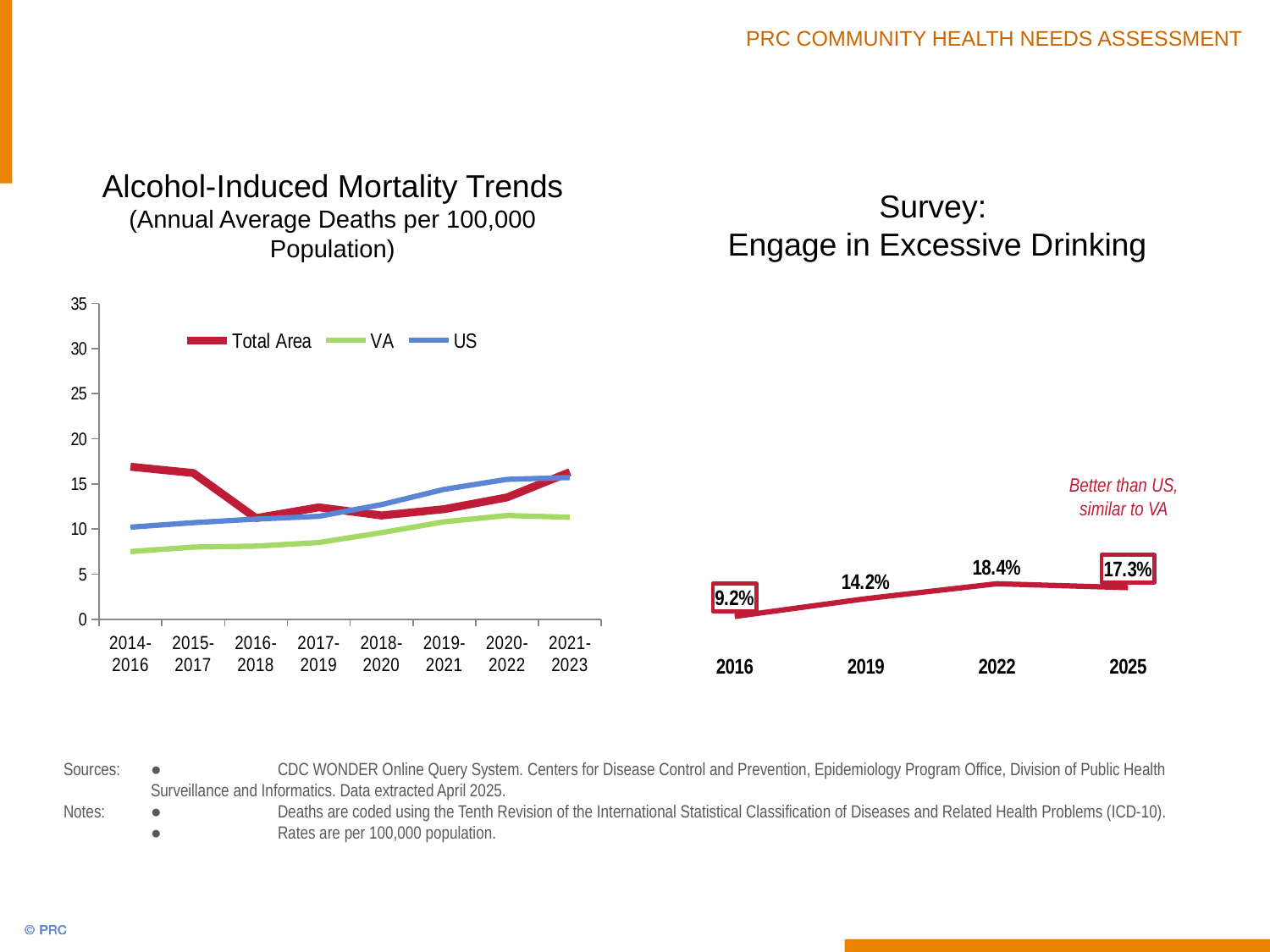
On the Survey: Engage in Excessive Drinking chart, which year has the lowest value? 2016 On the Survey: Engage in Excessive Drinking chart, what is the value for 2025? 17.3% On the Alcohol-Induced Mortality Trends chart, does the VA line generally rise or fall from 2014-2016 to 2021-2023? rise On the Survey: Engage in Excessive Drinking chart, what is the difference between the 2022 value and the 2016 value? 9.2 percentage points On the Survey: Engage in Excessive Drinking chart, what is the value for 2016? 9.2% On the Survey: Engage in Excessive Drinking chart, how many data points are plotted? 4 On the Alcohol-Induced Mortality Trends chart, is the Total Area value for 2014-2016 greater or less than 15? greater On the Survey: Engage in Excessive Drinking chart, which year has the highest value? 2022 On the Survey: Engage in Excessive Drinking chart, what is the value for 2022? 18.4% On the Survey: Engage in Excessive Drinking chart, which is larger, the value for 2019 or the value for 2025? 2025 On the Alcohol-Induced Mortality Trends chart, how many time periods are shown on the x axis? 8 On the Alcohol-Induced Mortality Trends chart, how many series does the legend list? 3